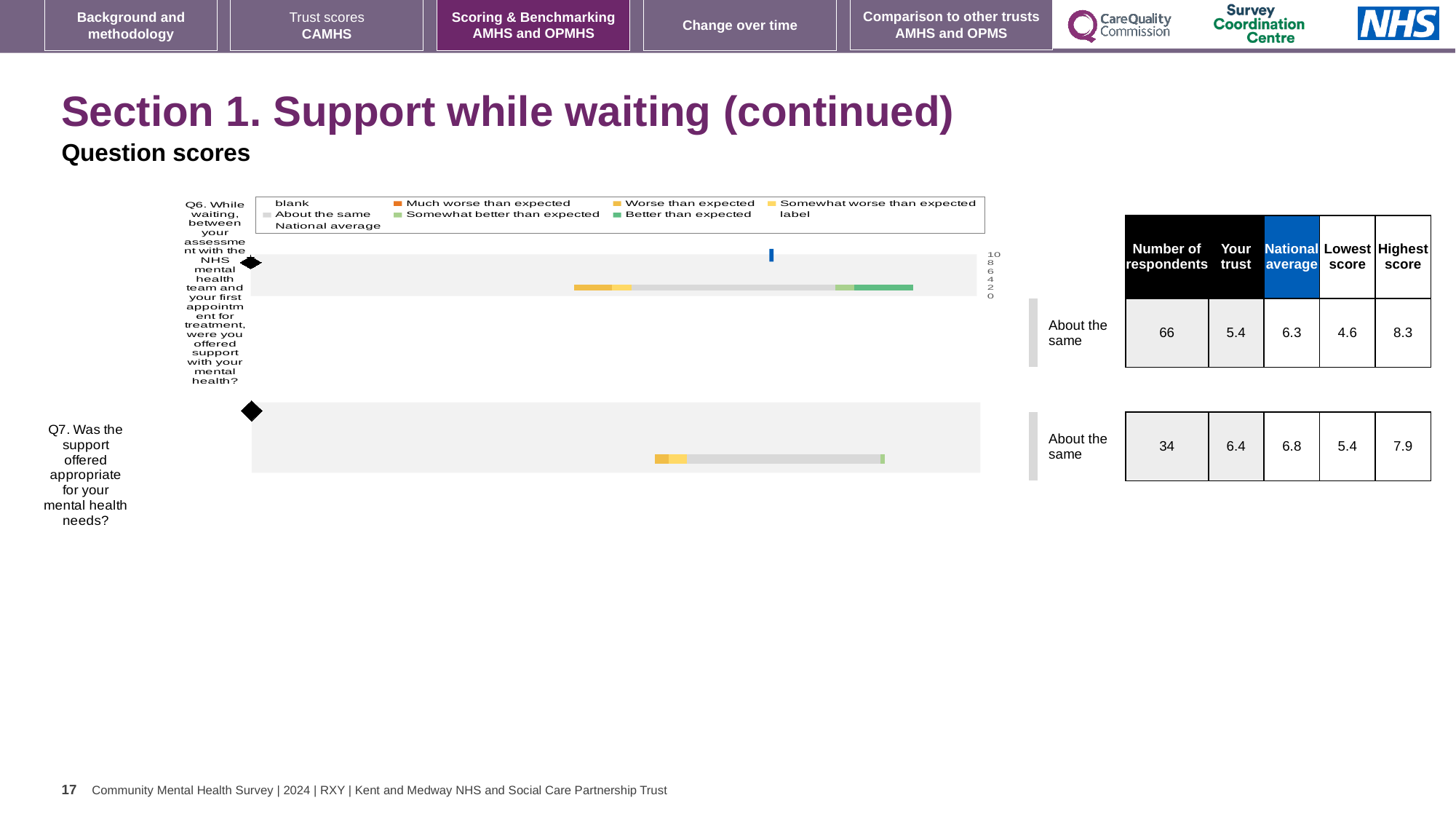
What kind of chart is used to show the Q6 and Q7 question scores? bar chart How many questions (bars) are plotted on the slide? 2 What benchmark category is shown for Q6? About the same What is the national average for Q7? 6.8 What colour is the 'Better than expected' legend entry? green How many entries does the chart legend list? 9 What is the highest score shown for Q7? 7.9 What is the difference between the highest score and the lowest score for Q7? 2.5 What is the 'Your trust' score for Q6? 5.4 What colour is the 'Much worse than expected' legend entry? orange Which question has the higher 'Your trust' score, Q6 or Q7? Q7 How many respondents answered Q6? 66